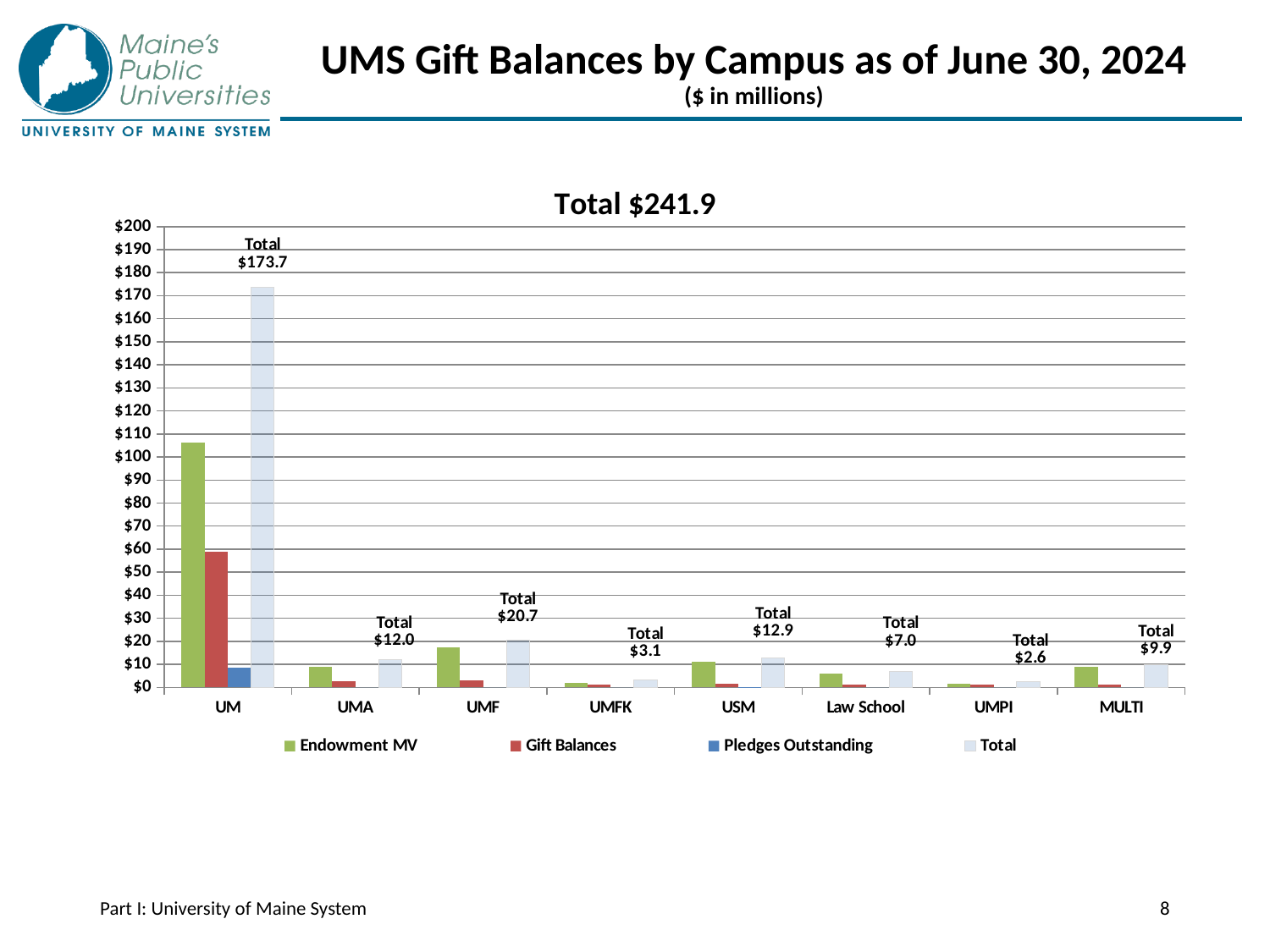
Which campus has the highest Total? UM How many series does the legend list? 4 What is the Total value shown for Law School? $7.0 What kind of chart is shown on the slide? Bar chart How many campuses are shown on the x axis? 8 What is the difference between the Total for UMF and the Total for UMA? $8.7 What overall total is given in the chart title? $241.9 Which has a larger Total, USM or MULTI? USM What is the Total value shown for UMF? $20.7 What is the Total value shown for UM? $173.7 Is the Endowment MV value for UM greater or less than $100? greater Which campus has the lowest Total? UMPI